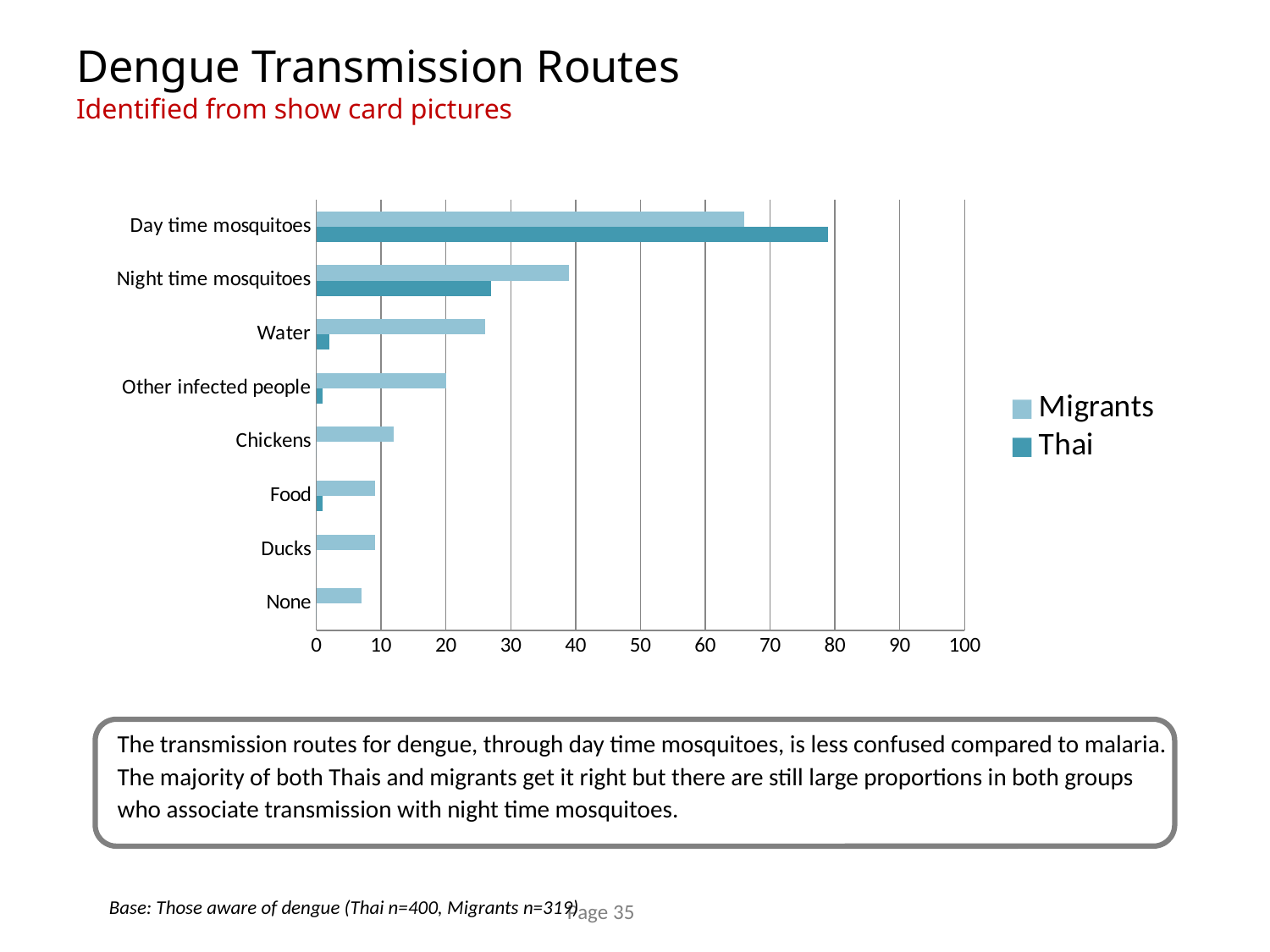
How many transmission route categories are plotted on the chart? 8 What are the two entries listed in the chart legend? Migrants and Thai How many series does the legend list? 2 Which category has the highest value for Thai? Day time mosquitoes For Night time mosquitoes, which series has the larger value, Migrants or Thai? Migrants Which category has the highest value for Migrants? Day time mosquitoes What kind of chart is shown on the slide? bar chart Is the Migrants value for Day time mosquitoes greater or less than 60? greater Is the Migrants value for Night time mosquitoes greater or less than 30? greater Is the Thai value for Day time mosquitoes greater or less than 70? greater For Day time mosquitoes, which series has the larger value, Migrants or Thai? Thai